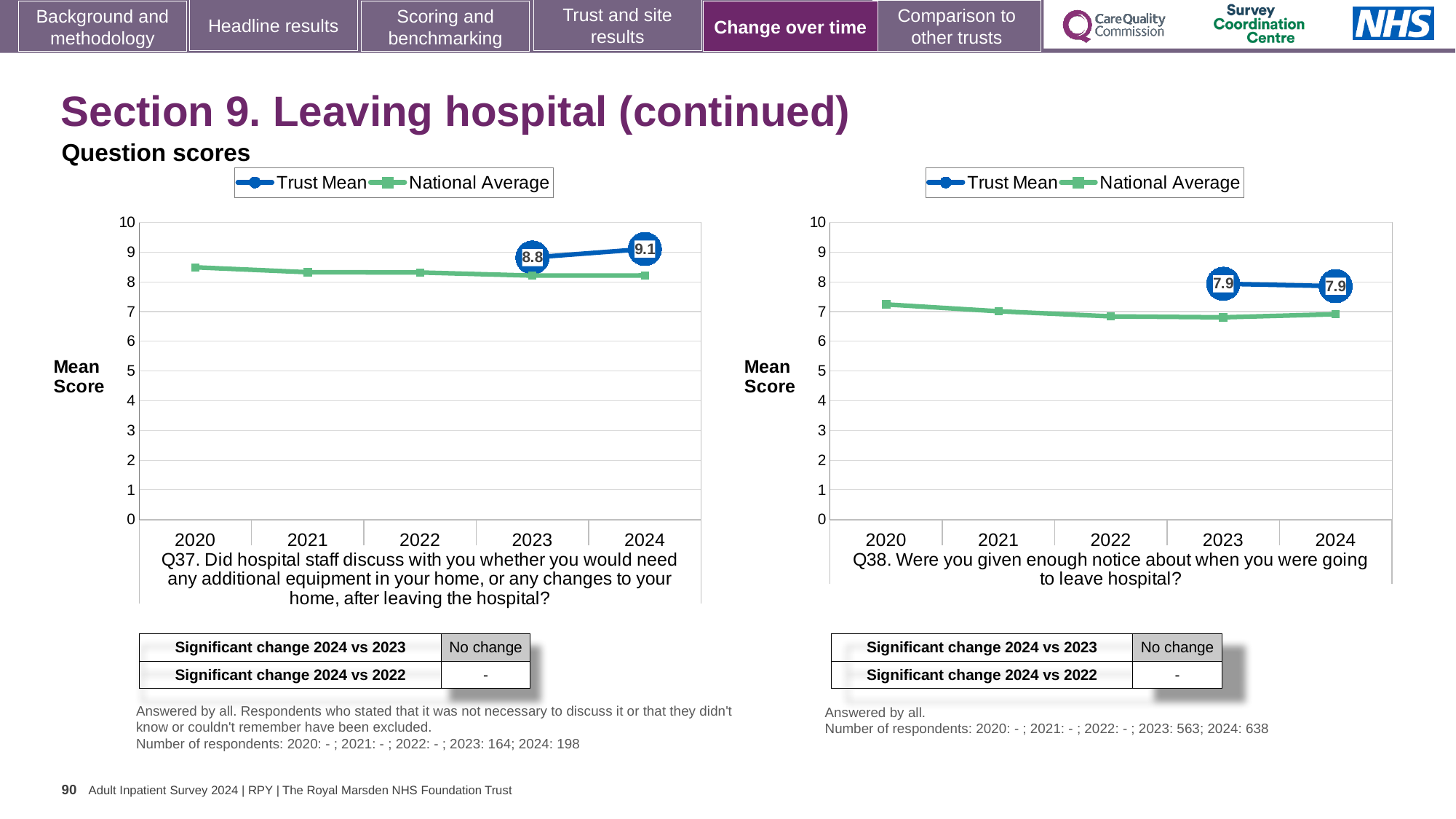
In the Q37 chart on the left, by how much did the Trust Mean change from 2023 to 2024? 0.3 How many years are shown on the x axis of the Q37 chart on the left? 5 In the Q37 chart on the left, which is higher in 2024: the Trust Mean or the National Average? Trust Mean How many series does the legend of the Q38 chart on the right list? 2 In the Q38 chart on the right, is the National Average value for 2020 greater or less than 8? less In the Q37 chart on the left, does the Trust Mean rise or fall from 2023 to 2024? Rise What kind of chart is the Q37 chart on the left? Line chart In the Q37 chart on the left, what is the Trust Mean score for 2024? 9.1 In the Q38 chart on the right, is the National Average value for 2022 greater or less than 7? less In the Q38 chart on the right, what is the Trust Mean score for 2024? 7.9 What is the label on the y axis of the Q38 chart on the right? Mean Score In the Q37 chart on the left, what is the Trust Mean score for 2023? 8.8